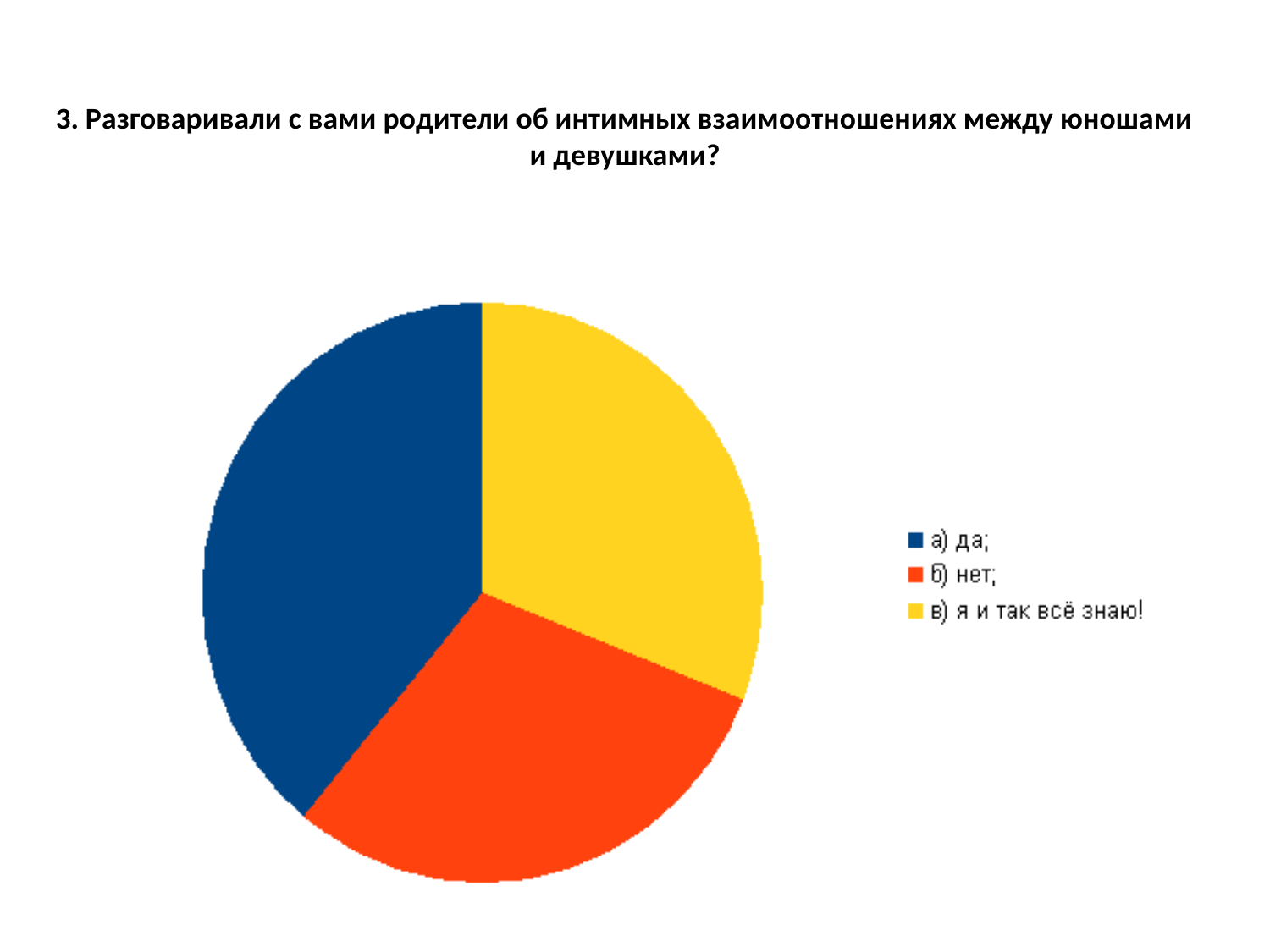
What kind of chart is shown on the slide? pie chart How many entries does the legend list? 3 Which answer option has the largest slice of the pie? а) да; Which slice is larger: "а) да;" or "в) я и так всё знаю!"? а) да; How many slices does the pie chart have? 3 Which legend entry is shown in yellow? в) я и так всё знаю! What colour is the slice for "б) нет;"? red Which slice is larger: "а) да;" or "б) нет;"? а) да;